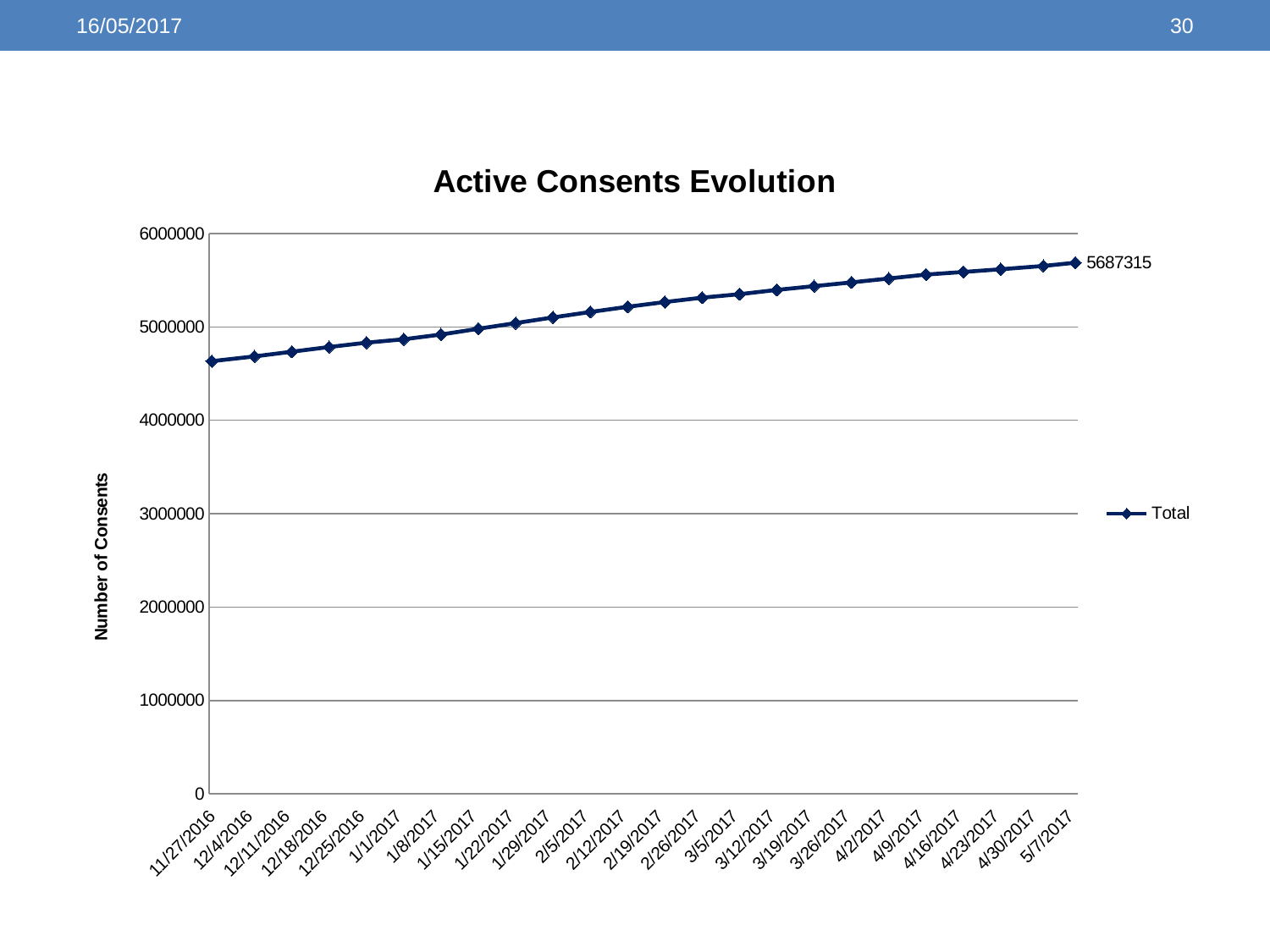
How many series does the legend list? 1 How many data points are plotted on the line? 24 Is the value for 3/5/2017 greater or less than 5000000? greater Which date has the lowest value? 11/27/2016 What is the title of the chart? Active Consents Evolution Which date has the highest value? 5/7/2017 What type of chart is shown on the slide? line chart Which is larger, the value for 12/25/2016 or the value for 4/2/2017? 4/2/2017 What is the value of the data label shown at the last point (5/7/2017)? 5687315 Is the value for 11/27/2016 greater or less than 5000000? less Do the values rise or fall along the x axis from 11/27/2016 to 5/7/2017? rise What is the name of the series shown in the legend? Total